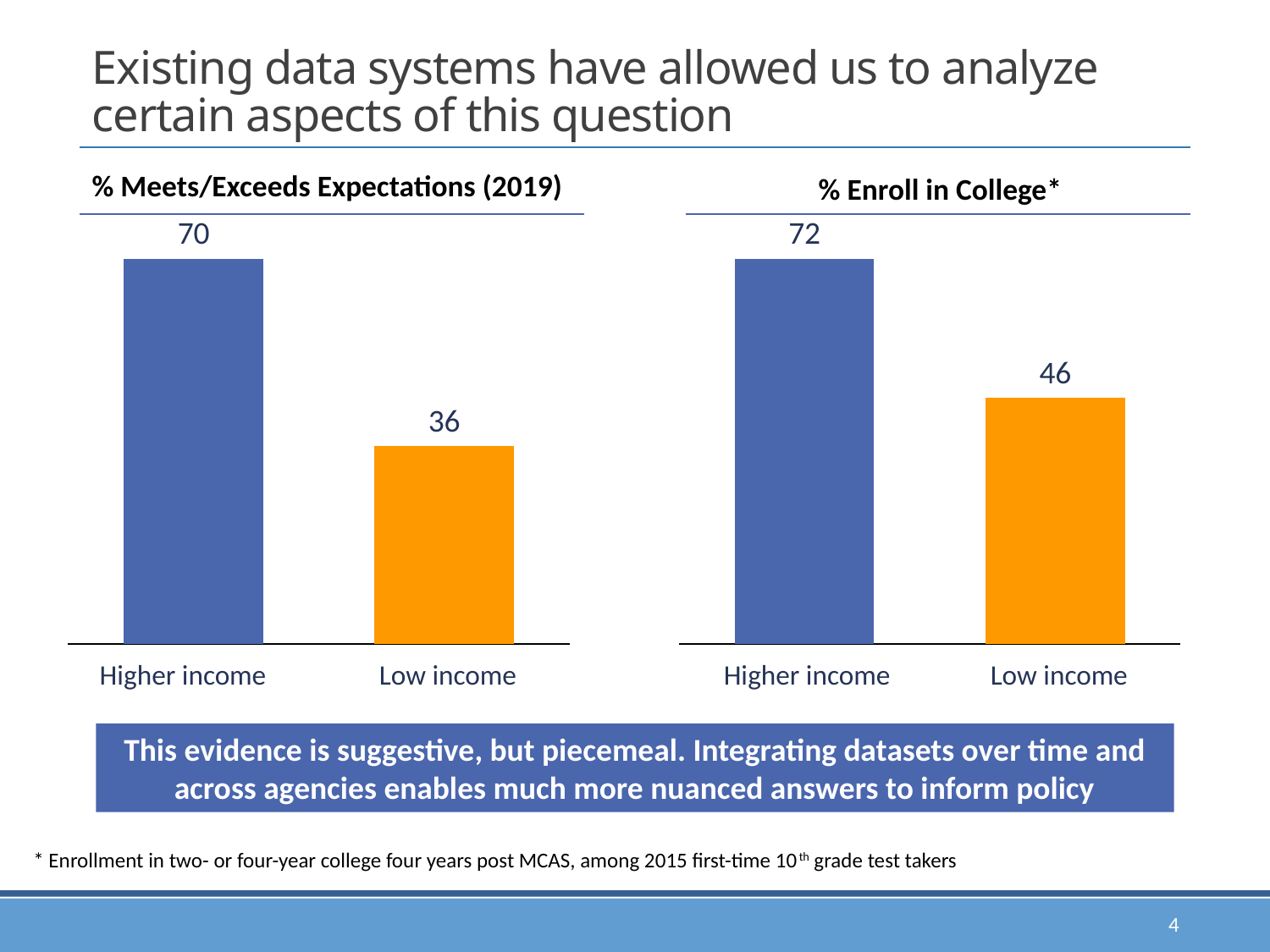
In the '% Enroll in College*' chart, what is the difference between the Higher income and Low income values? 26 In the '% Meets/Exceeds Expectations (2019)' chart, what is the difference between the Higher income and Low income values? 34 In the '% Meets/Exceeds Expectations (2019)' chart, what colour is the Low income bar? Orange In the '% Enroll in College*' chart, which category has the lowest value? Low income What kind of chart is the '% Enroll in College*' chart? Bar chart In the '% Meets/Exceeds Expectations (2019)' chart, what is the value for Low income? 36 In the '% Enroll in College*' chart, what is the value for Low income? 46 In the '% Enroll in College*' chart, what is the value for Higher income? 72 In the '% Meets/Exceeds Expectations (2019)' chart, what is the value for Higher income? 70 In the '% Enroll in College*' chart, which is larger, the value for Higher income or Low income? Higher income How many categories are shown in the '% Meets/Exceeds Expectations (2019)' chart? 2 In the '% Meets/Exceeds Expectations (2019)' chart, which category has the highest value? Higher income